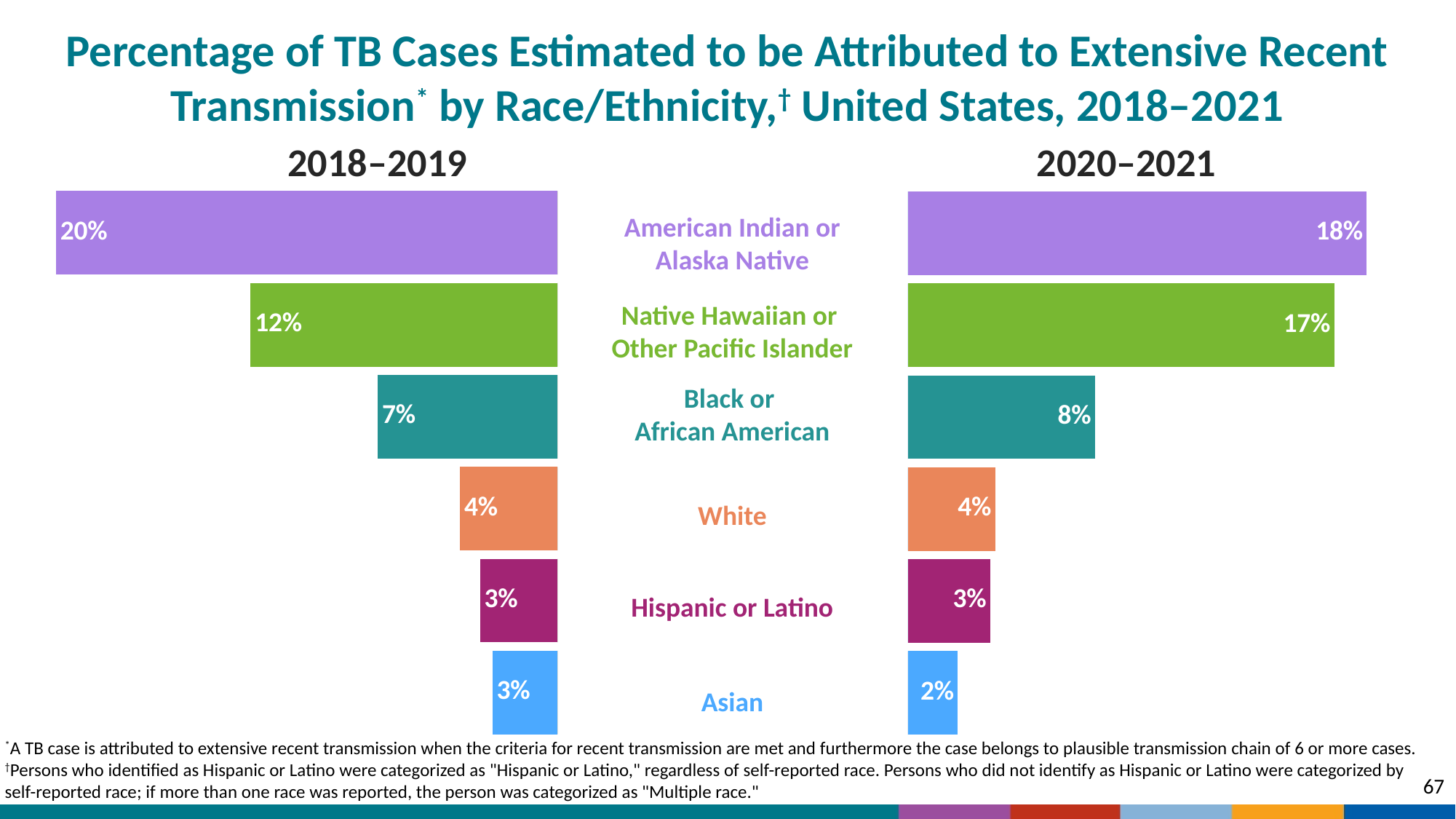
How many race/ethnicity categories are shown in each chart? 6 In the 2020–2021 chart, what is the value for Asian? 2% What colour are the bars for the White category? Orange In the 2018–2019 chart, what is the value for Black or African American? 7% In the 2020–2021 chart, what is the value for Native Hawaiian or Other Pacific Islander? 17% In the 2020–2021 chart, which race/ethnicity group has the lowest percentage? Asian In the 2018–2019 chart, what is the difference between the American Indian or Alaska Native value and the Black or African American value? 13% In the 2018–2019 chart, which race/ethnicity group has the highest percentage? American Indian or Alaska Native Is the value for American Indian or Alaska Native larger in the 2018–2019 chart or the 2020–2021 chart? 2018–2019 What is the difference between the Native Hawaiian or Other Pacific Islander values in the 2020–2021 chart and the 2018–2019 chart? 5% In the 2018–2019 chart, what percentage of TB cases is attributed to extensive recent transmission for American Indian or Alaska Native persons? 20% What kind of chart is used on this slide? Bar chart